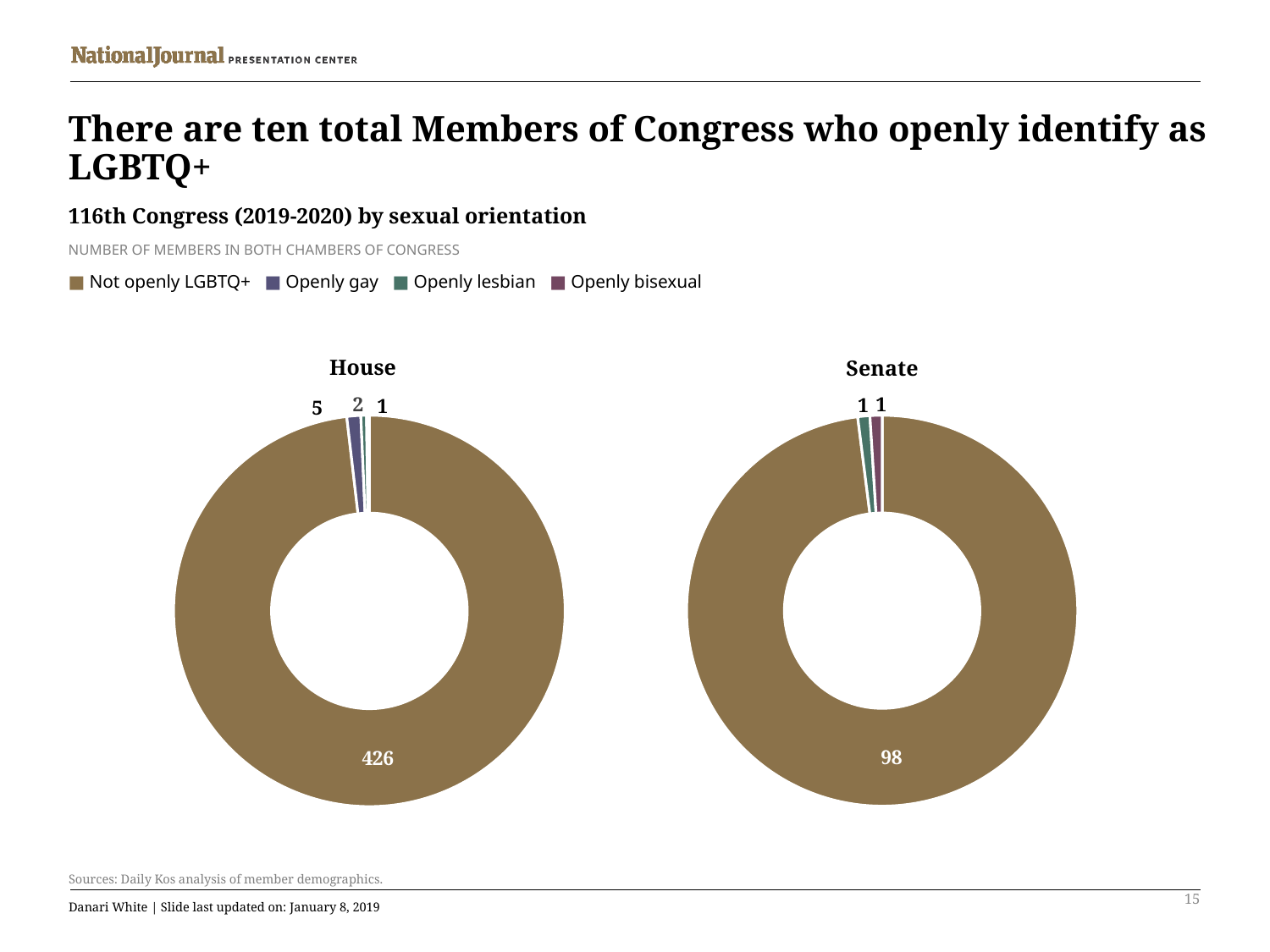
In the House chart, how many members are openly gay? 5 In the House chart, which category has the largest slice? Not openly LGBTQ+ Comparing the two charts, which chamber has more members who are not openly LGBTQ+, the House or the Senate? House In the House chart, which category has the smallest slice? Openly bisexual In the House chart, what is the difference between the number of openly gay members and openly lesbian members? 3 What is the total number of members shown in the Senate chart? 100 In the House chart, how many members are not openly LGBTQ+? 426 In the Senate chart, how many members are not openly LGBTQ+? 98 In the Senate chart, what share of members are not openly LGBTQ+? 98% How many categories does the legend list? 4 What kind of chart is used for the House and Senate? Donut (pie) chart In the House chart, how many members are openly lesbian? 2